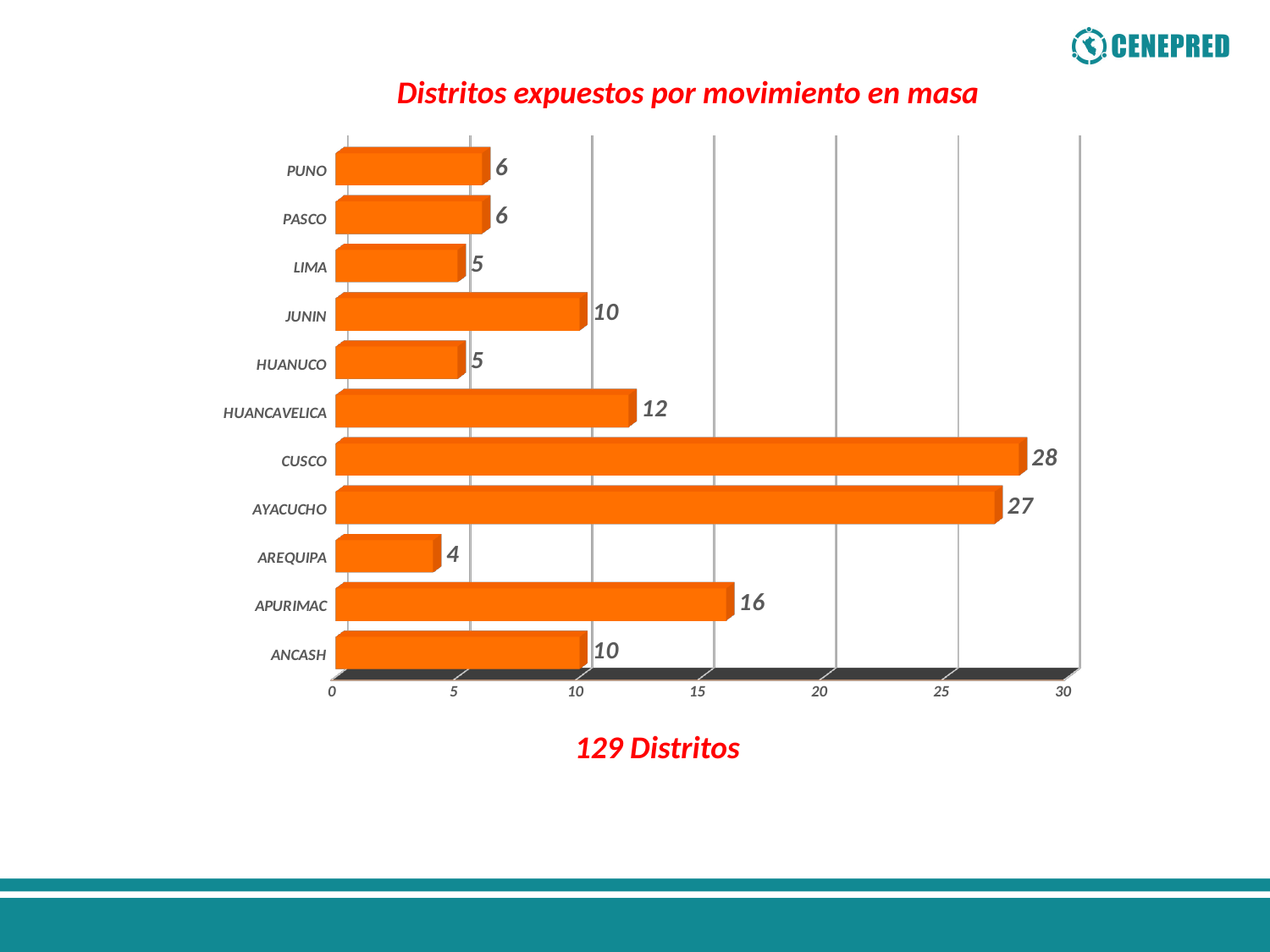
What is the difference between the values for APURIMAC and JUNIN? 6 What is the title of the chart? Distritos expuestos por movimiento en masa Which category has the lowest value? AREQUIPA What kind of chart is shown on the slide? bar chart Which is larger, the value for HUANCAVELICA or the value for ANCASH? HUANCAVELICA Is the value for AYACUCHO greater or less than 25? greater What is the value for HUANCAVELICA? 12 What is the value for CUSCO? 28 What is the value for APURIMAC? 16 How many categories are shown in the chart? 11 What is the difference between the values for CUSCO and AYACUCHO? 1 Which category has the highest value? CUSCO